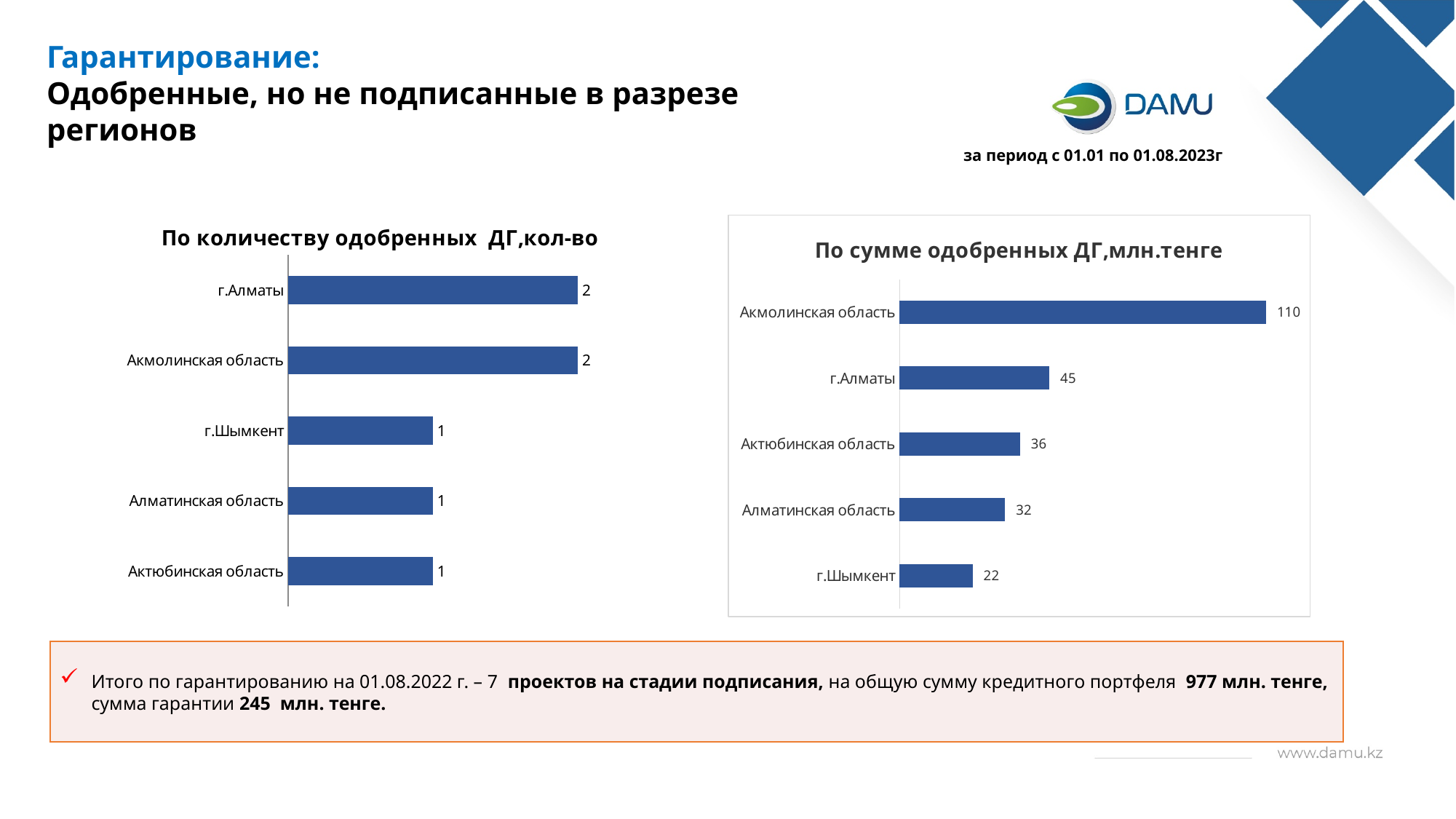
In the chart 'По сумме одобренных ДГ,млн.тенге', which is larger: Актюбинская область or Алматинская область? Актюбинская область In the chart 'По сумме одобренных ДГ,млн.тенге', what is the value for Алматинская область? 32 In the chart 'По количеству одобренных ДГ,кол-во', what is the difference between г.Алматы and Актюбинская область? 1 In the chart 'По количеству одобренных ДГ,кол-во', what is the value for г.Шымкент? 1 What type of chart is 'По количеству одобренных ДГ,кол-во'? Bar chart In the chart 'По сумме одобренных ДГ,млн.тенге', what is the value for Акмолинская область? 110 How many regions are shown in the chart 'По сумме одобренных ДГ,млн.тенге'? 5 In the chart 'По количеству одобренных ДГ,кол-во', what is the value for г.Алматы? 2 In the chart 'По сумме одобренных ДГ,млн.тенге', which region has the highest value? Акмолинская область What is the title of the chart on the right side of the slide? По сумме одобренных ДГ,млн.тенге In the chart 'По сумме одобренных ДГ,млн.тенге', which region has the lowest value? г.Шымкент In the chart 'По сумме одобренных ДГ,млн.тенге', what is the difference between Акмолинская область and г.Алматы? 65